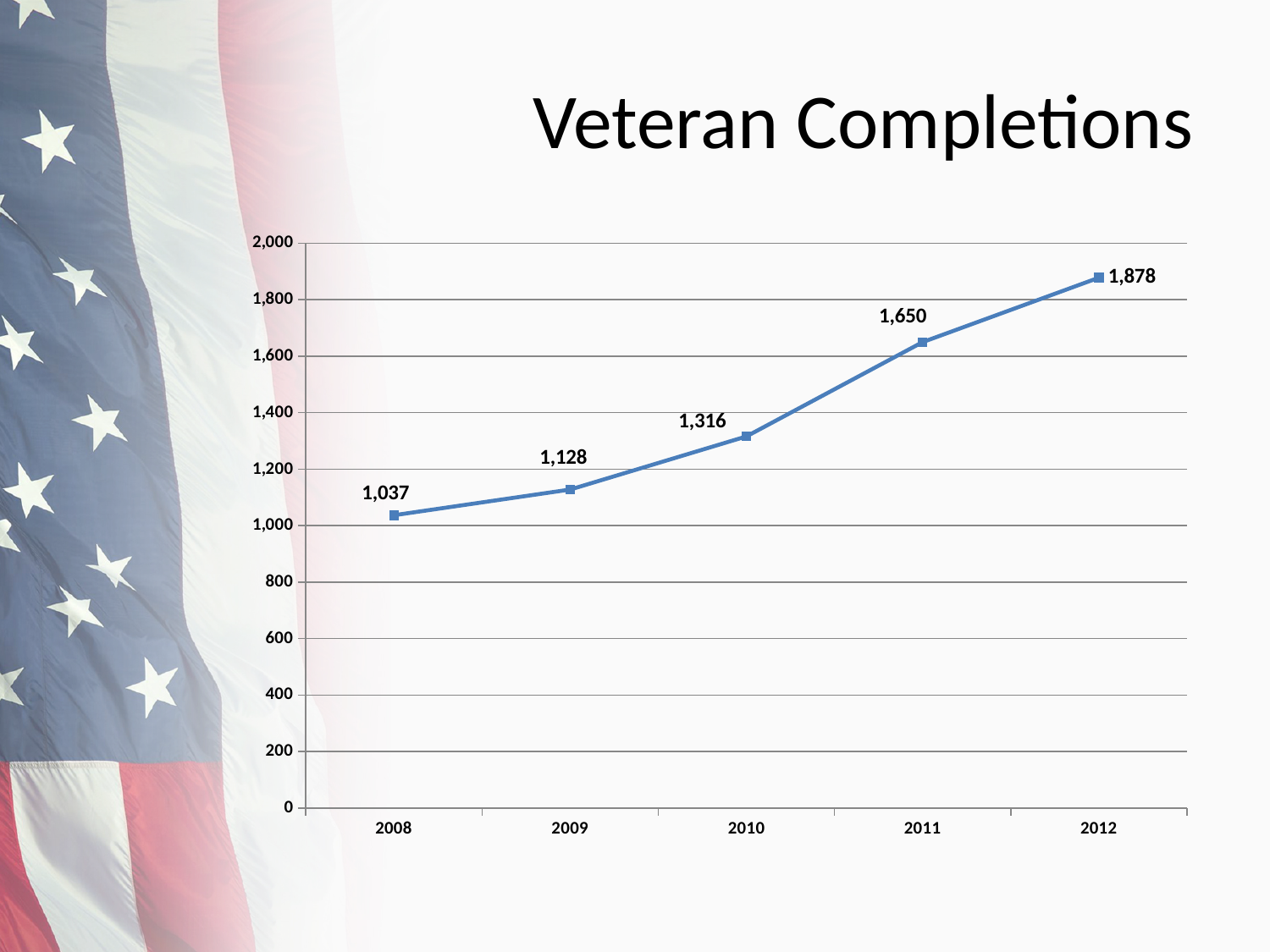
How many years are plotted on the chart? 5 What is the difference between the values for 2012 and 2011? 228 What kind of chart is shown on the slide? line chart Which year has the highest value? 2012 Which is larger, the value for 2010 or the value for 2011? 2011 What is the value for 2012? 1,878 What is the value for 2008? 1,037 Is the value for 2011 greater or less than 1,600? greater What is the difference between the values for 2009 and 2008? 91 Which year has the lowest value? 2008 What is the value for 2010? 1,316 Do the values rise or fall from 2008 to 2012? rise